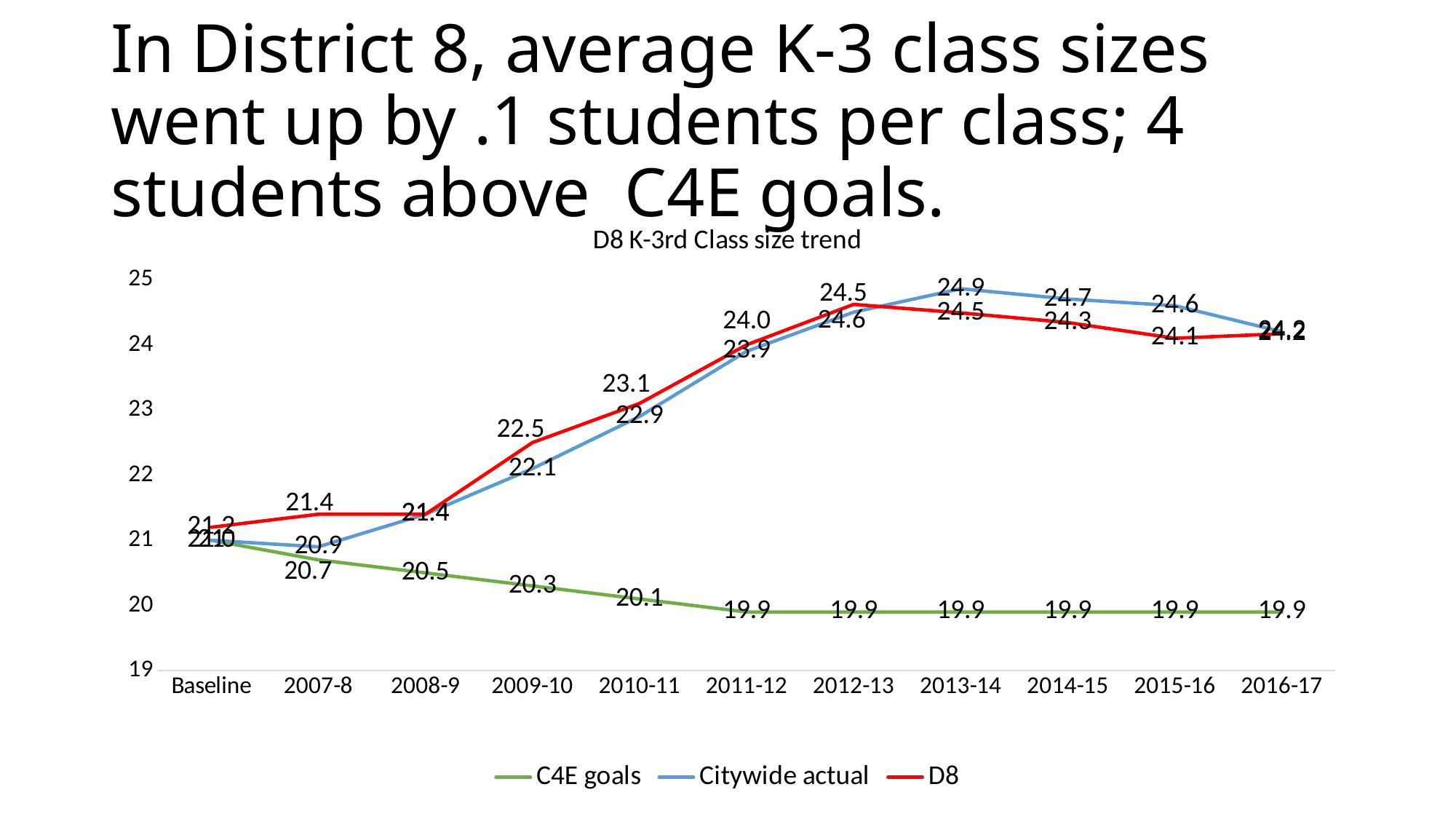
What is the C4E goals value for 2010-11? 20.1 In which year is the Citywide actual value highest? 2013-14 At which point is the D8 value lowest? Baseline How many points are plotted along the x axis for each series? 11 How many series does the legend list? 3 In 2015-16, which is larger: Citywide actual or D8? Citywide actual What is the Citywide actual value for 2013-14? 24.9 Do the C4E goals values rise or fall from Baseline to 2016-17? fall What is the D8 value for 2009-10? 22.5 What is the difference between the D8 value and the C4E goals value in 2016-17? 4.3 What kind of chart is shown on the slide? line chart What is the D8 value for 2016-17? 24.2